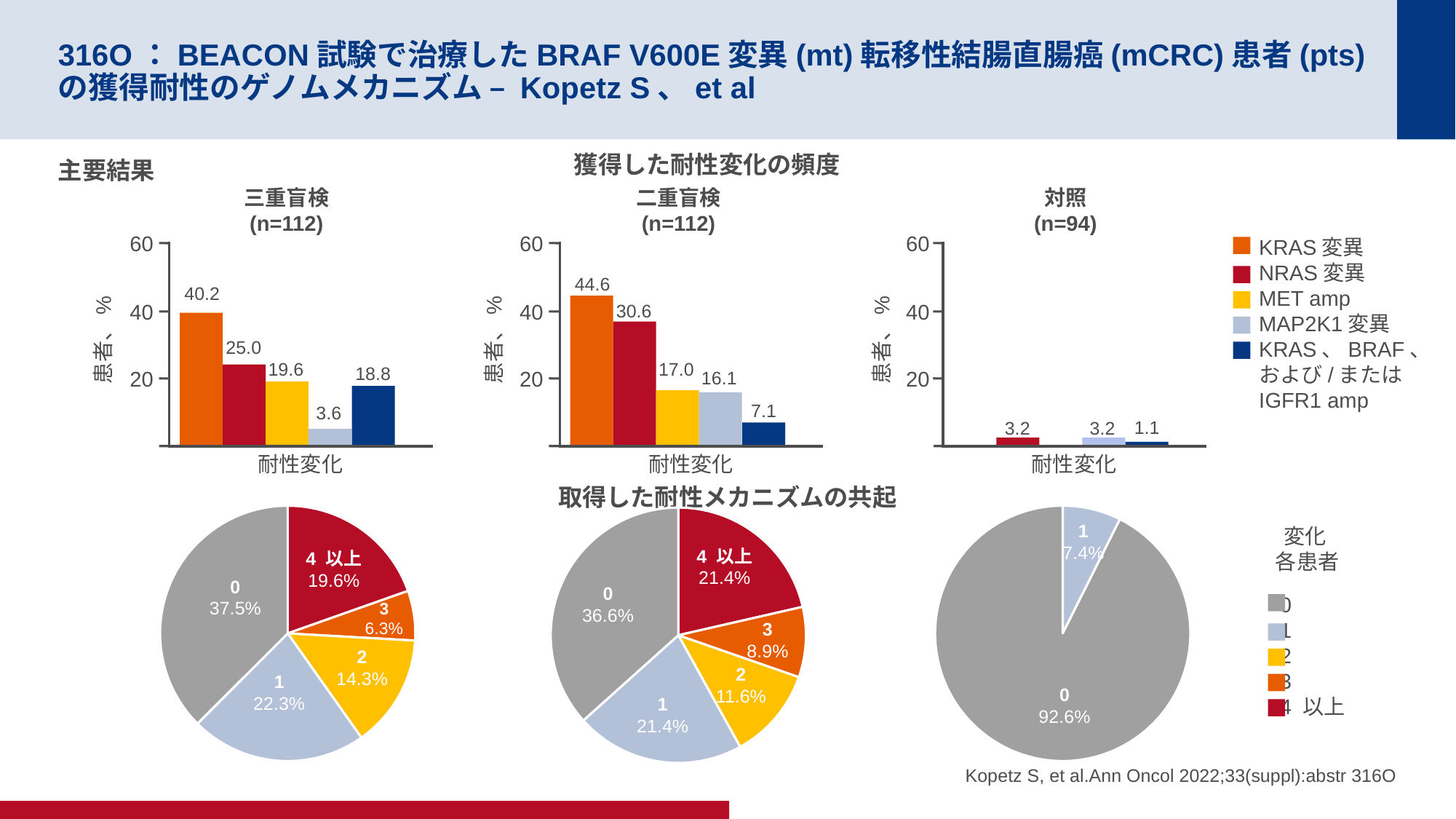
In the 三重盲検 (n=112) bar chart, which resistance alteration has the lowest value? MAP2K1 変異 In the 対照 (n=94) bar chart, what is the value for NRAS 変異? 3.2 In the 三重盲検 (n=112) bar chart, which is larger: MET amp or MAP2K1 変異? MET amp What kind of chart is used for the 取得した耐性メカニズムの共起 section? Pie chart In the 二重盲検 (n=112) bar chart, what is the difference between the KRAS 変異 value and the NRAS 変異 value? 14.0 How many series does the legend of the bar charts list? 5 In the 二重盲検 (n=112) bar chart, what is the value for NRAS 変異? 30.6 In the 三重盲検 pie chart, what share of patients had 0 changes? 37.5% In the 対照 pie chart, what share of patients had 1 change? 7.4% In the 三重盲検 (n=112) bar chart, what is the value for KRAS 変異? 40.2 In the 二重盲検 pie chart, what share of patients had 4 以上 changes? 21.4% In the 二重盲検 (n=112) bar chart, which resistance alteration has the highest value? KRAS 変異